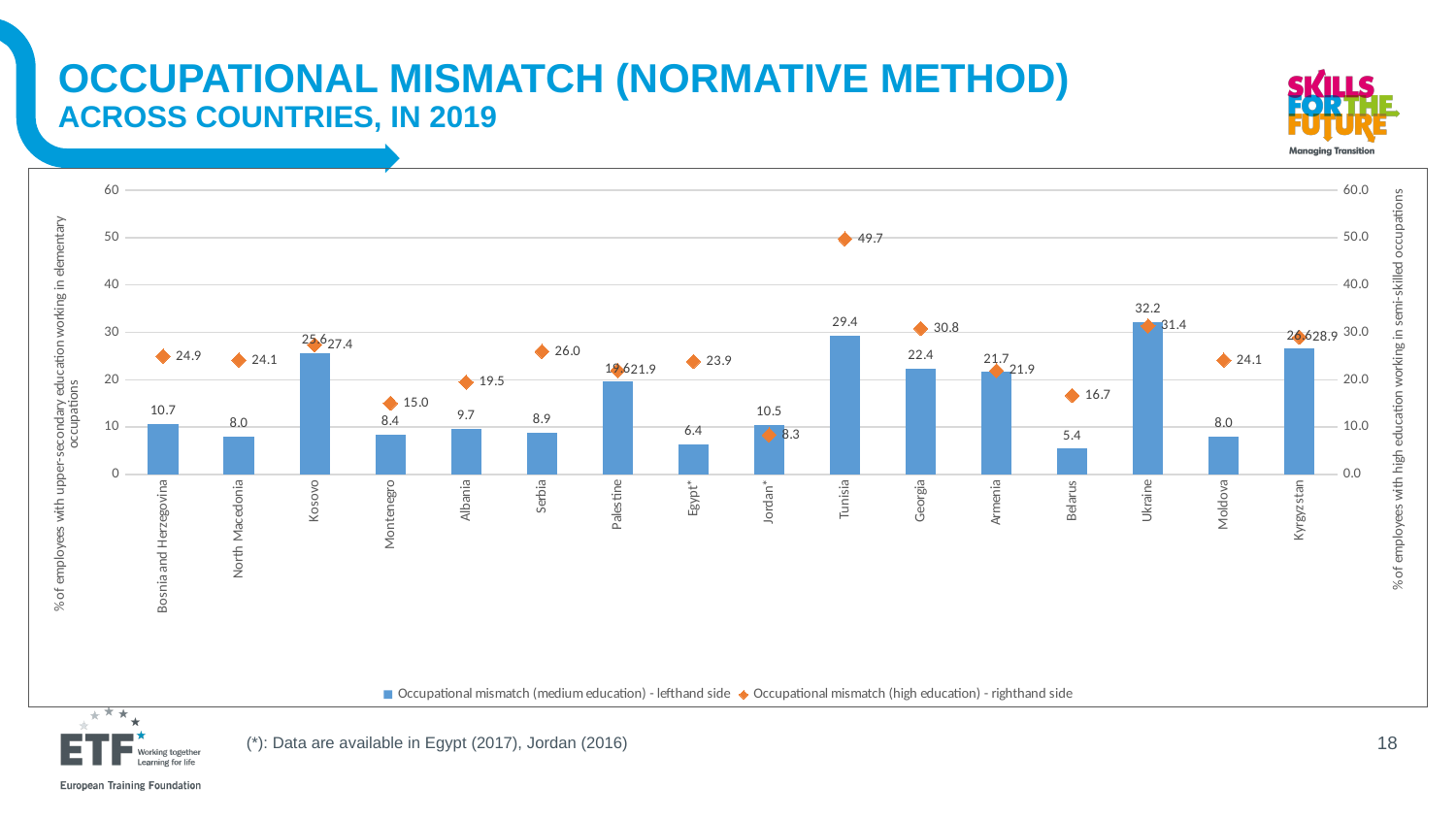
Which country has the lowest occupational mismatch (medium education) value? Belarus Which country has the lowest occupational mismatch (high education) value? Jordan* What is the occupational mismatch (medium education) value for Tunisia? 29.4 What is the occupational mismatch (high education) value for Montenegro? 15.0 Which country has the highest occupational mismatch (high education) value? Tunisia Which has a larger occupational mismatch (medium education) value, Georgia or Armenia? Georgia Which country has the highest occupational mismatch (medium education) value? Ukraine What is the occupational mismatch (medium education) value for Belarus? 5.4 What is the occupational mismatch (high education) value for Georgia? 30.8 How many countries are shown on the x axis? 16 How many series does the legend list? 2 What is the difference between the occupational mismatch (medium education) values for Ukraine and Tunisia? 2.8